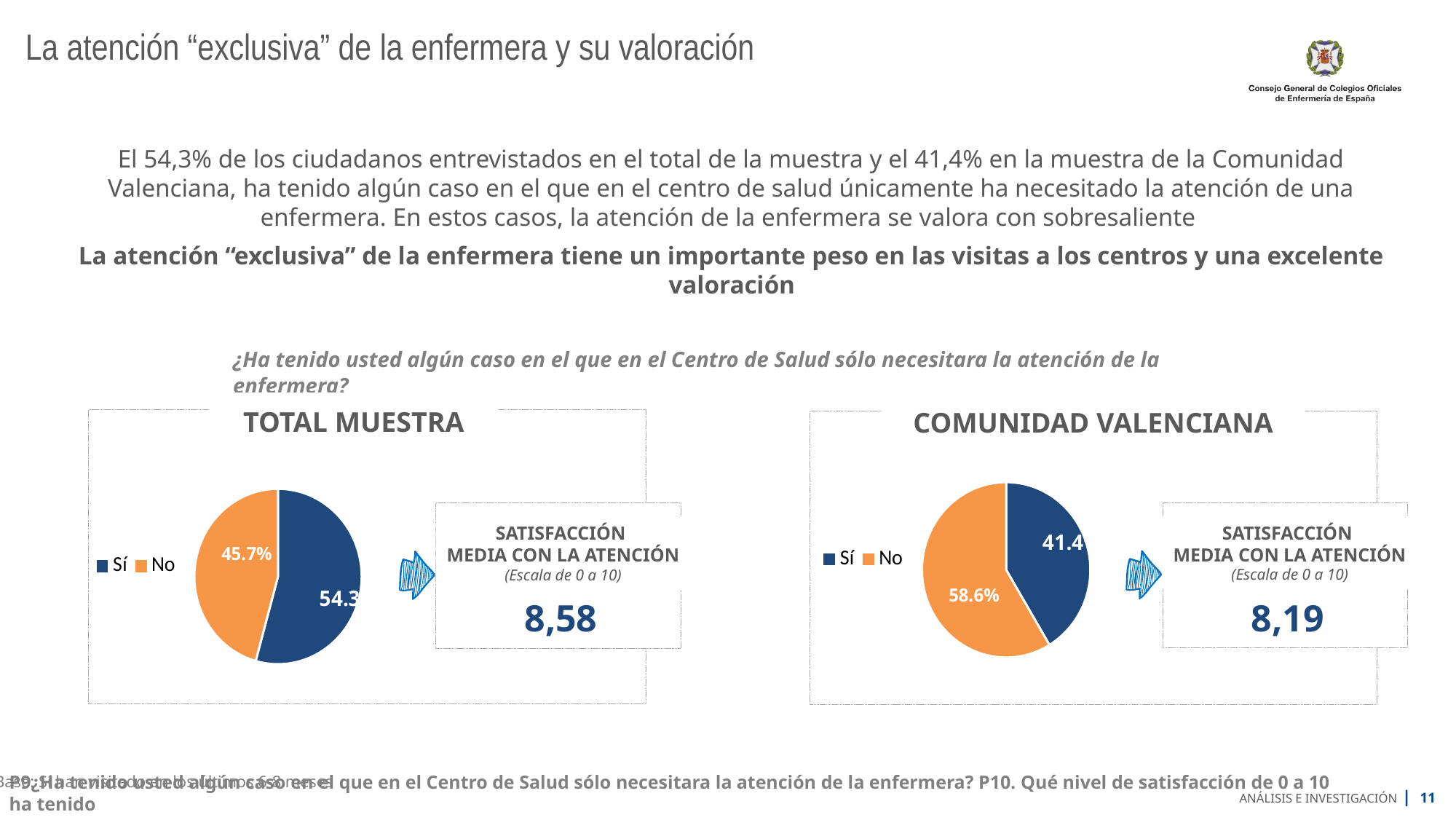
In the COMUNIDAD VALENCIANA pie chart, which slice is larger, Sí or No? No In the COMUNIDAD VALENCIANA pie chart, what colour is the No slice? Orange How many slices does the COMUNIDAD VALENCIANA pie chart have? 2 What type of chart is used under TOTAL MUESTRA? Pie chart In the TOTAL MUESTRA pie chart, what share of respondents answered No? 45.7% In the TOTAL MUESTRA pie chart, what is the difference between the Sí and No shares? 8.6 In the COMUNIDAD VALENCIANA pie chart, what share of respondents answered No? 58.6% In the COMUNIDAD VALENCIANA pie chart, what value is shown for Sí? 41.4 In the TOTAL MUESTRA pie chart, what value is shown for Sí? 54.3 How many entries does the legend of the TOTAL MUESTRA pie chart list? 2 What is the title of the pie chart on the right side of the slide? COMUNIDAD VALENCIANA In the TOTAL MUESTRA pie chart, which slice is larger, Sí or No? Sí